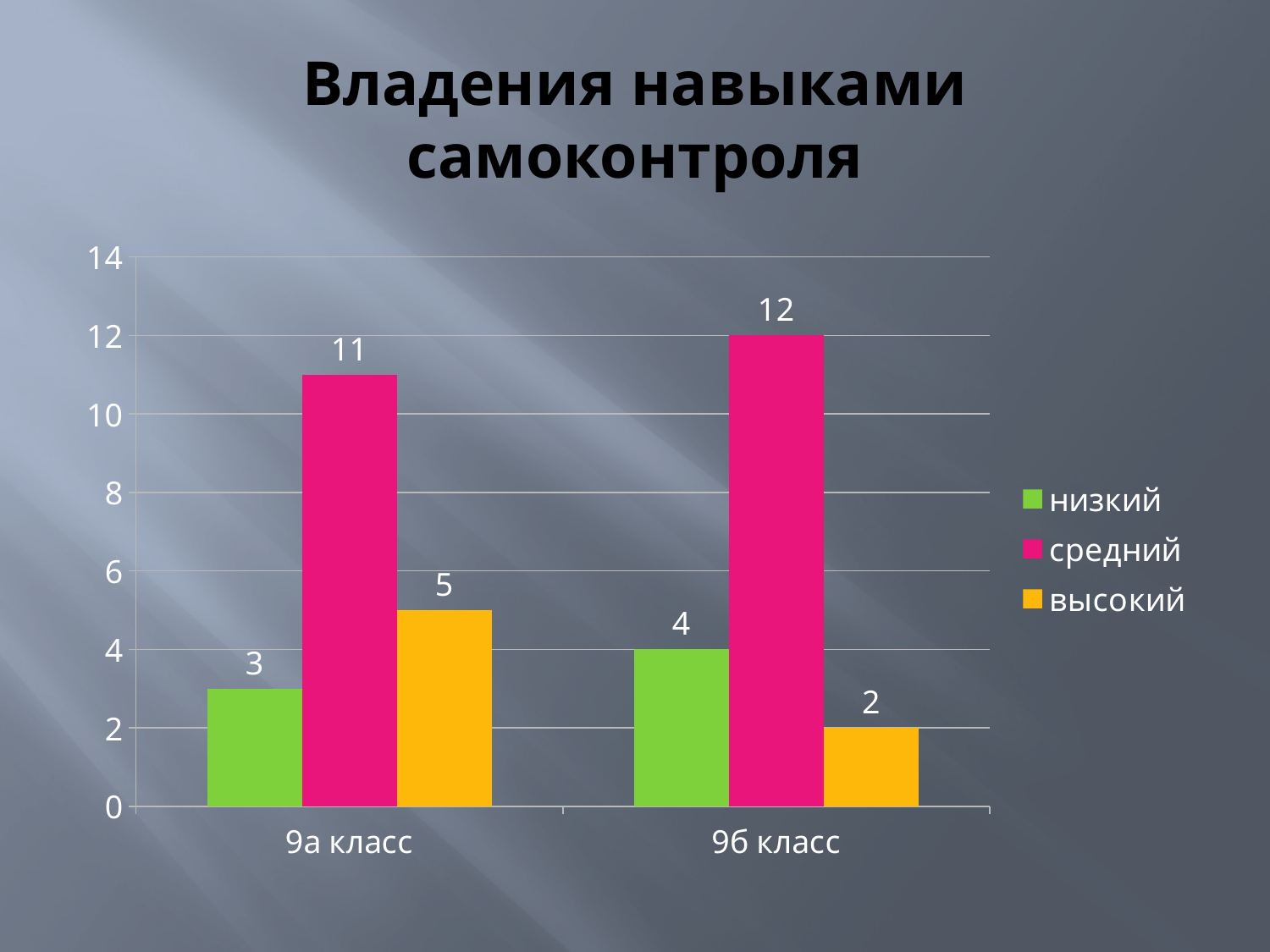
What is the value for средний in 9б класс? 12 Which is larger: низкий in 9а класс or низкий in 9б класс? 9б класс What is the value for высокий in 9а класс? 5 What is the title of the chart? Владения навыками самоконтроля What kind of chart is shown on the slide? bar chart Which series has the highest value in 9а класс? средний What is the difference between средний in 9б класс and средний in 9а класс? 1 How many categories are shown on the x axis? 2 What is the value for высокий in 9б класс? 2 What is the value for низкий in 9а класс? 3 How many series does the legend list? 3 Which series has the lowest value in 9б класс? высокий